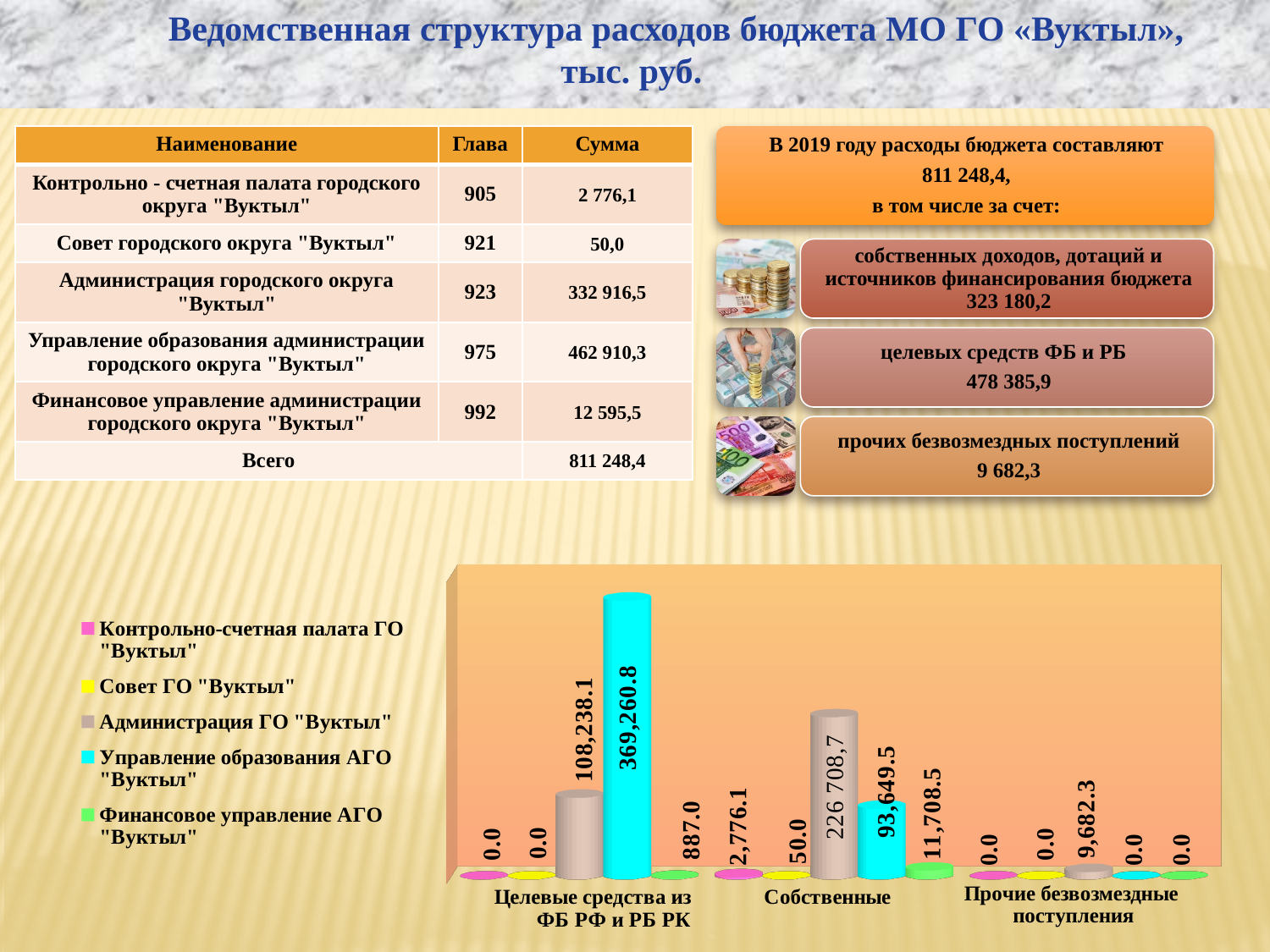
Which series has the highest value in the Собственные category? Администрация ГО "Вуктыл" Which series has the highest value in the Целевые средства из ФБ РФ и РБ РК category? Управление образования АГО "Вуктыл" In the Собственные category, which is larger: the value for Управление образования АГО "Вуктыл" or for Финансовое управление АГО "Вуктыл"? Управление образования АГО "Вуктыл" What is the value for Контрольно-счетная палата ГО "Вуктыл" in the Собственные category? 2,776.1 What kind of chart is shown on the slide? Bar chart What is the value for Управление образования АГО "Вуктыл" in the Целевые средства из ФБ РФ и РБ РК category? 369,260.8 What is the value for Администрация ГО "Вуктыл" in the Собственные category? 226 708,7 What is the difference between the values for Управление образования АГО "Вуктыл" and Администрация ГО "Вуктыл" in the Целевые средства из ФБ РФ и РБ РК category? 261,022.7 How many categories are shown on the x axis of the chart? 3 How many series does the chart legend list? 5 What is the value for Финансовое управление АГО "Вуктыл" in the Собственные category? 11,708.5 What is the value for Администрация ГО "Вуктыл" in the Прочие безвозмездные поступления category? 9,682.3